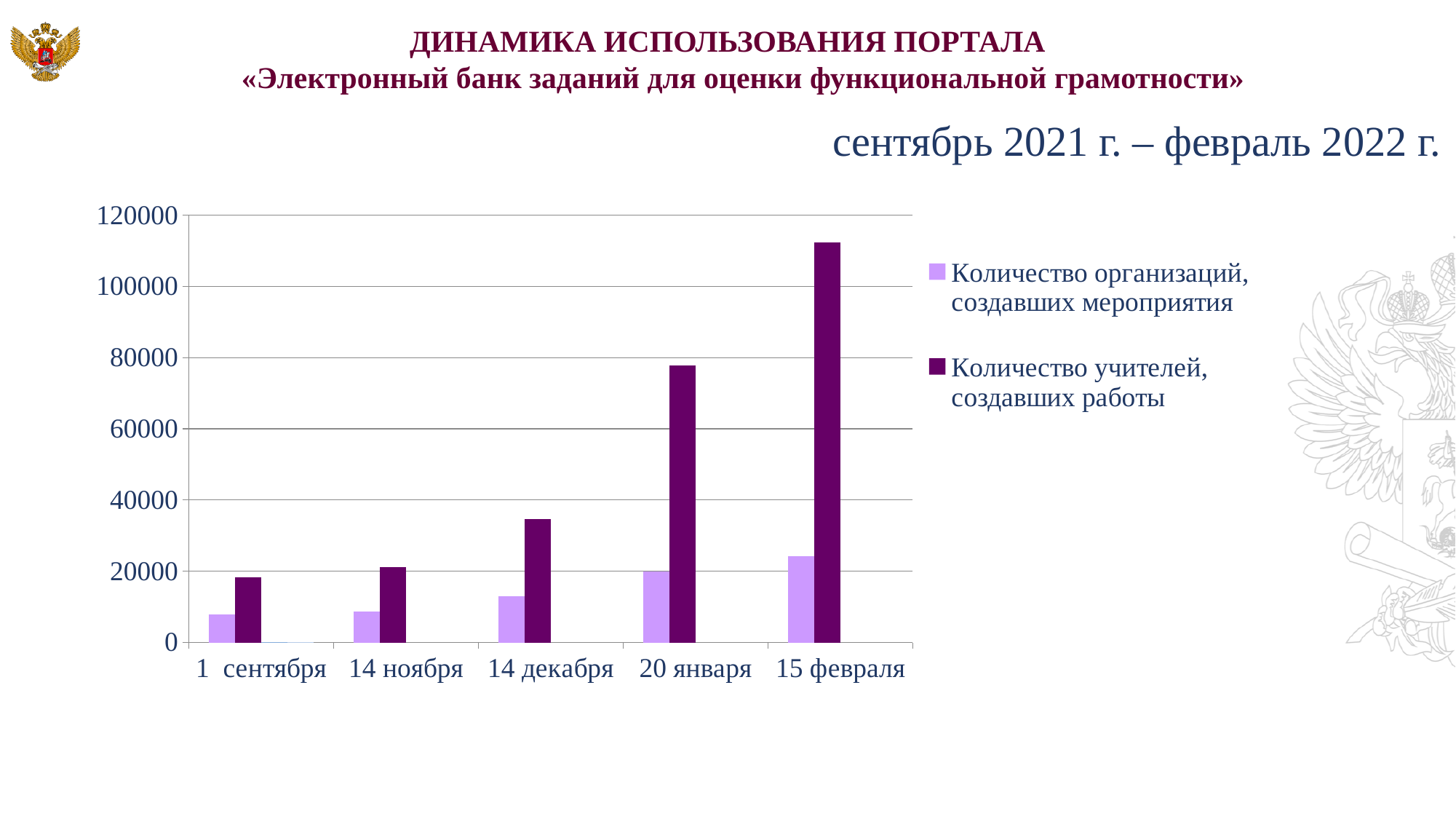
On 15 февраля, which series has the larger value: «Количество организаций, создавших мероприятия» or «Количество учителей, создавших работы»? Количество учителей, создавших работы What kind of chart is shown on the slide? bar chart On which date is the value for «Количество учителей, создавших работы» lowest? 1 сентября On which date is the value for «Количество организаций, создавших мероприятия» highest? 15 февраля Do the values for «Количество учителей, создавших работы» rise or fall from 1 сентября to 15 февраля? rise Is the value for «Количество учителей, создавших работы» on 20 января greater or less than 60000? greater Is the value for «Количество организаций, создавших мероприятия» on 1 сентября greater or less than 20000? less Is the value for «Количество учителей, создавших работы» on 15 февраля greater or less than 100000? greater How many dates are shown along the x axis? 5 On which date is the value for «Количество учителей, создавших работы» highest? 15 февраля How many series does the legend list? 2